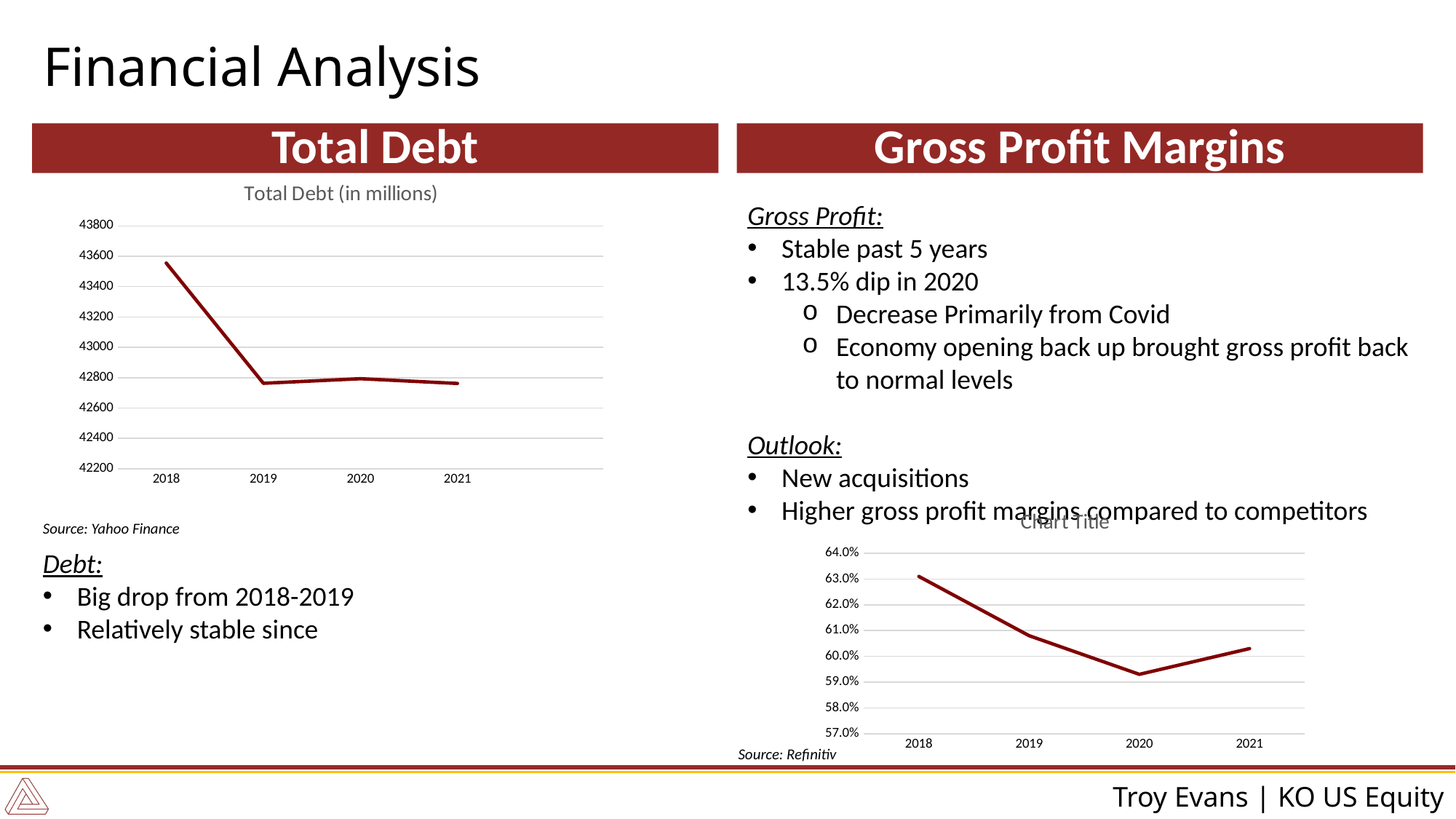
On the gross profit margins chart on the right, which year has the lowest value? 2020 On the Total Debt (in millions) chart, is the value for 2018 greater or less than 43400? greater What kind of chart is the gross profit margins chart on the right side of the slide? line chart How many years are plotted on the Total Debt (in millions) chart? 4 On the gross profit margins chart on the right, which year has the highest value? 2018 On the gross profit margins chart on the right, is the value for 2018 greater or less than 62.0%? greater On the gross profit margins chart on the right, is the value for 2020 greater or less than 60.0%? less What is the title of the chart on the left side of the slide? Total Debt (in millions) On the Total Debt (in millions) chart, does total debt rise or fall from 2018 to 2019? fall On the Total Debt (in millions) chart, which year has the highest total debt? 2018 What kind of chart is the Total Debt (in millions) chart? line chart